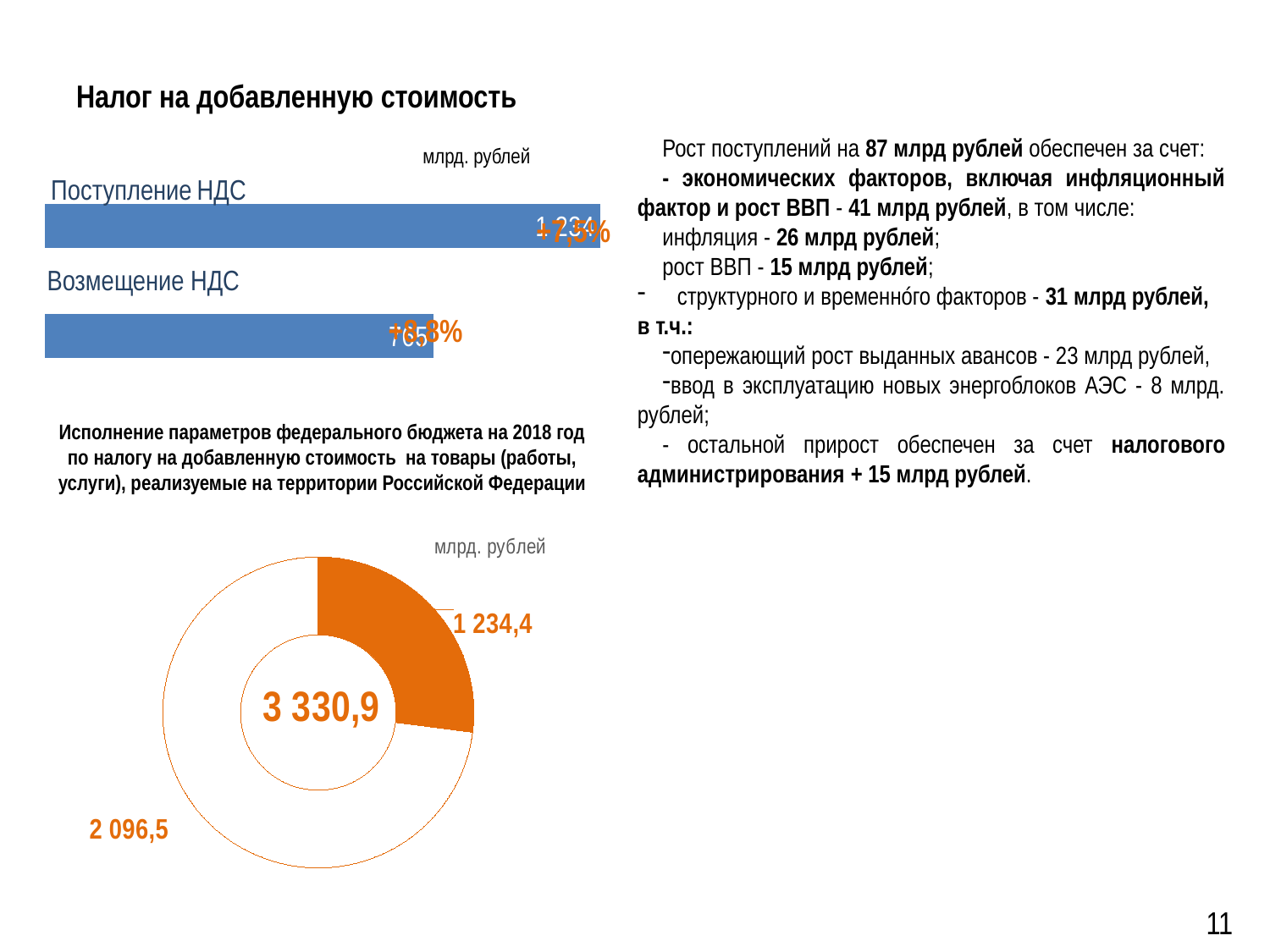
What kind of chart is the bottom-left chart on the slide? doughnut chart In the top-left bar chart, which category has the shortest bar? Возмещение НДС In the bottom-left doughnut chart, what is the difference between the two slice values, 2 096,5 and 1 234,4? 862,1 In the top-left bar chart, which category has the longer bar, Поступление НДС or Возмещение НДС? Поступление НДС In the bottom-left doughnut chart, how many slices does the doughnut have? 2 In the bottom-left doughnut chart, what value is labelled on the white (unfilled) slice? 2 096,5 In the top-left bar chart, how many bars are plotted? 2 What kind of chart is the top-left chart on the slide? bar chart In the bottom-left doughnut chart, which slice is larger, the one labelled 1 234,4 or the one labelled 2 096,5? 2 096,5 In the bottom-left doughnut chart, what value is labelled on the orange slice? 1 234,4 In the top-left bar chart, what unit is stated above the chart? млрд. рублей In the bottom-left doughnut chart, what value is shown in the centre of the doughnut? 3 330,9